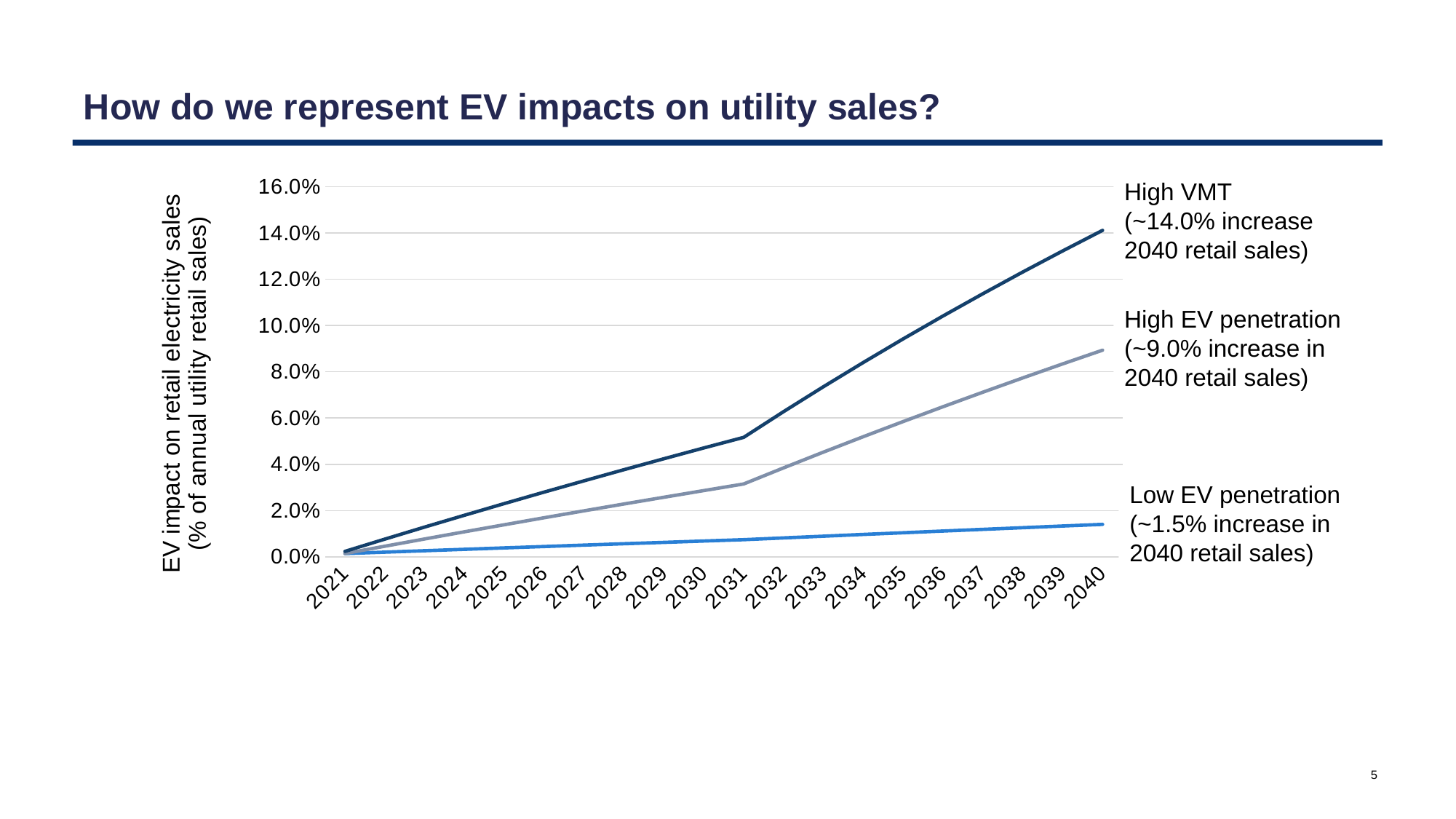
Is the value for Low EV penetration in 2040 greater or less than 2.0%? less Is the value for High EV penetration in 2040 greater or less than 10.0%? less Which scenario has the lowest value in 2040? Low EV penetration Which scenario has the highest value in 2040? High VMT What kind of chart is shown on the slide? line chart Is the value for High VMT in 2031 greater or less than 4.0%? greater What is the title of the y axis? EV impact on retail electricity sales (% of annual utility retail sales) How many years are shown along the x axis? 20 Do the values for the High VMT line rise or fall from 2021 to 2040? rise In 2031, which is larger: the High VMT value or the High EV penetration value? High VMT How many series (lines) are plotted on the chart? 3